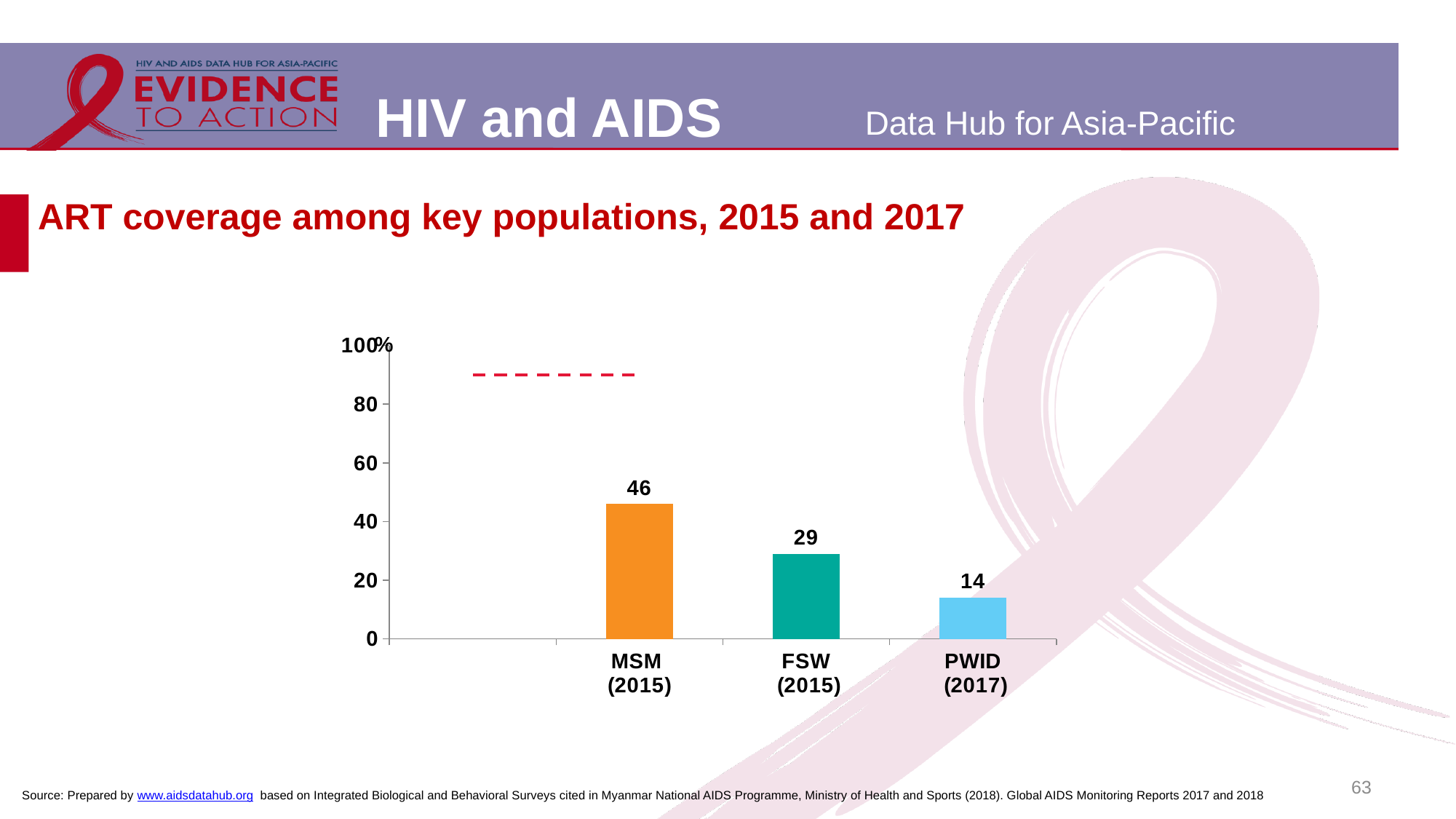
What is the title of the chart on the slide? ART coverage among key populations, 2015 and 2017 What kind of chart is shown on the slide? Bar chart What is the difference between the ART coverage for FSW (2015) and PWID (2017)? 15 What is the ART coverage value for PWID (2017)? 14 Which key population has the highest ART coverage? MSM (2015) Is the value for MSM (2015) greater or less than 40? greater Which has a larger ART coverage value, FSW (2015) or PWID (2017)? FSW (2015) What is the ART coverage value for MSM (2015)? 46 How many key population categories are shown in the chart? 3 What is the ART coverage value for FSW (2015)? 29 What is the difference between the ART coverage for MSM (2015) and FSW (2015)? 17 Which key population has the lowest ART coverage? PWID (2017)